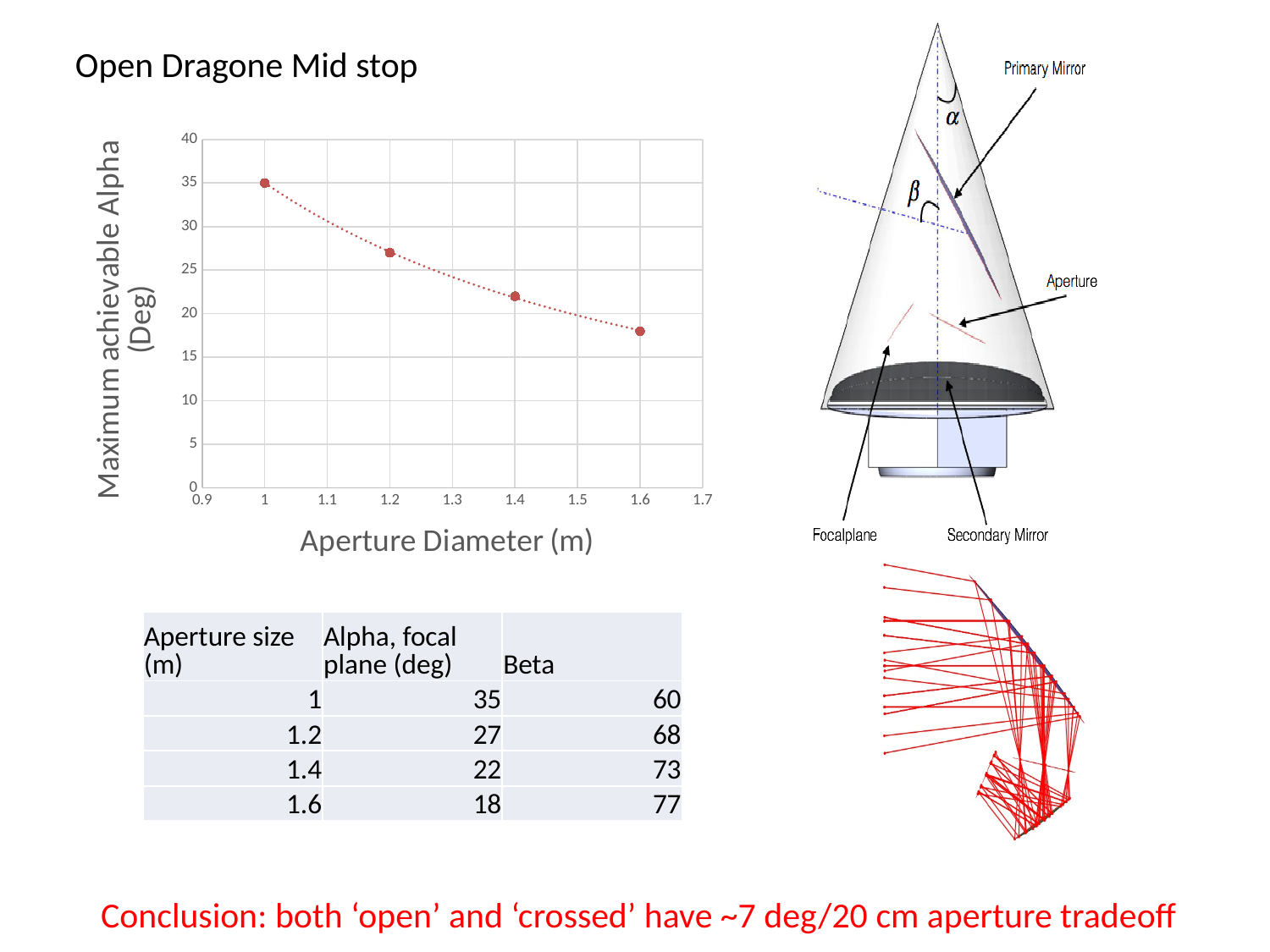
Which has a larger maximum achievable alpha, aperture diameter 1.2 or 1.4? 1.2 Is the value for aperture diameter 1.4 greater or less than 25? less Is the value for aperture diameter 1.2 greater or less than 25? greater How many data points are plotted on the chart? 4 At which aperture diameter is the maximum achievable alpha highest? 1 What is the title of the x axis of the chart? Aperture Diameter (m) What is the title of the y axis of the chart? Maximum achievable Alpha (Deg) What is the maximum achievable alpha at an aperture diameter of 1.6 m? 18 At which aperture diameter is the maximum achievable alpha lowest? 1.6 Do the values of maximum achievable alpha rise or fall as aperture diameter increases? fall What kind of chart is shown on the slide? scatter chart What is the maximum achievable alpha at an aperture diameter of 1 m? 35